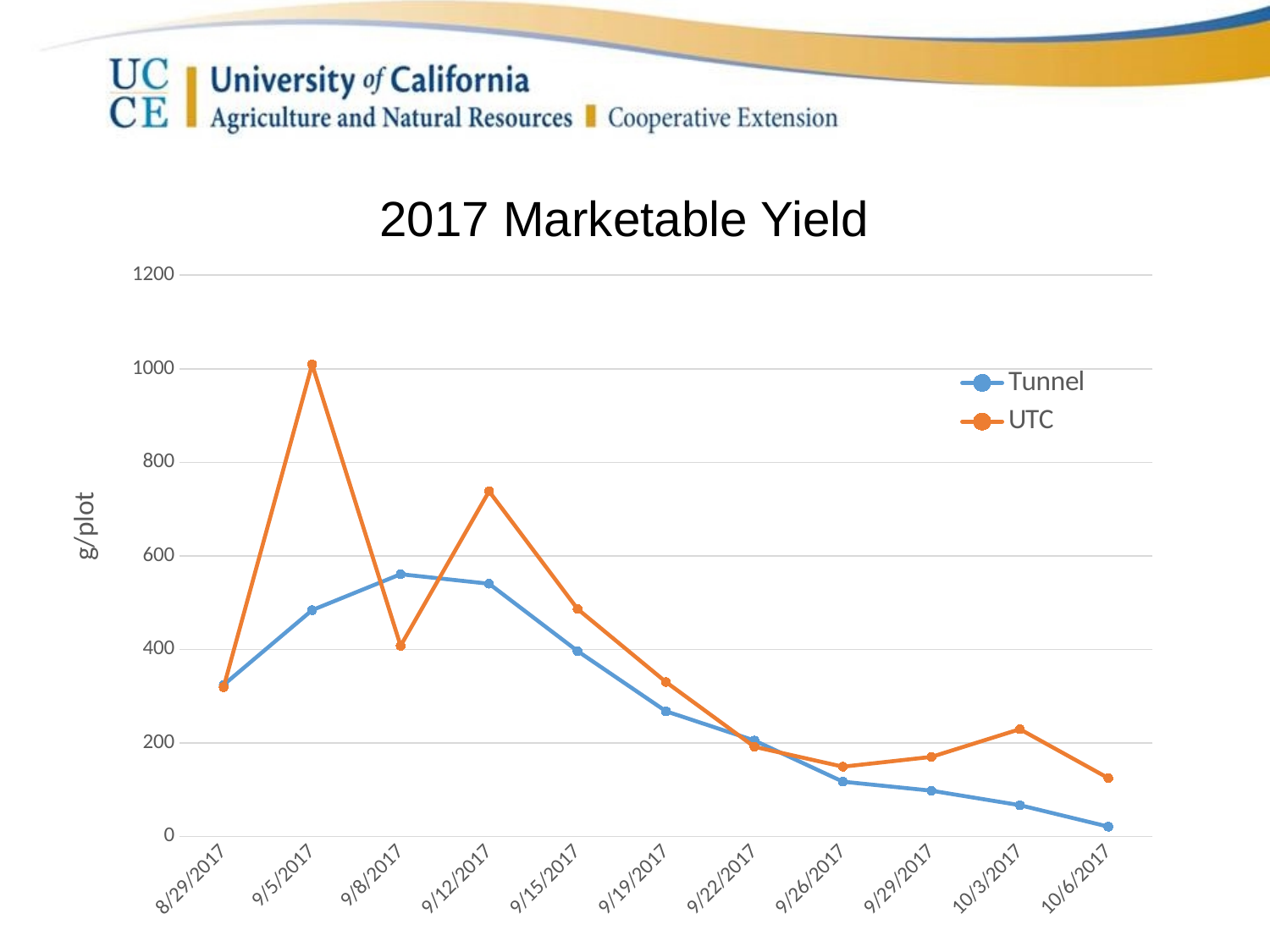
Does the Tunnel series rise or fall from 9/8/2017 to 10/6/2017? fall How many dates are plotted along the x axis? 11 What is the title of the chart? 2017 Marketable Yield On 9/5/2017, which series has the larger value, Tunnel or UTC? UTC On which date does the UTC series reach its highest value? 9/5/2017 On 9/8/2017, which series has the larger value, Tunnel or UTC? Tunnel On which date does the Tunnel series reach its lowest value? 10/6/2017 Is the Tunnel value on 10/6/2017 greater or less than 200? less How many series does the legend list? 2 What kind of chart is shown on the slide? line chart Is the UTC value on 9/5/2017 greater or less than 800? greater On which date does the Tunnel series reach its highest value? 9/8/2017